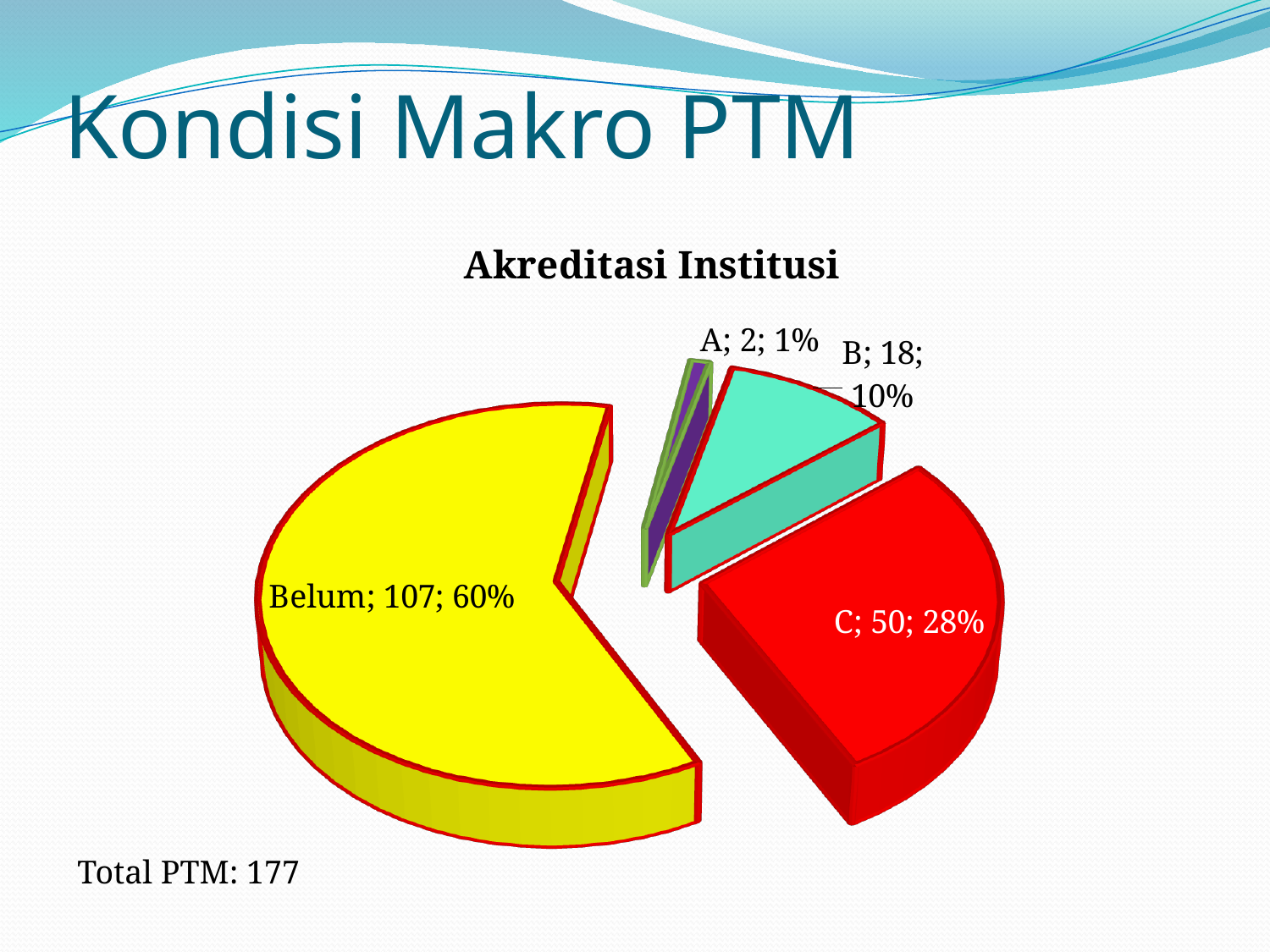
What kind of chart is shown on the slide? pie chart What share of the pie does the Belum slice represent? 60% What is the value for the B slice? 18 Which slice is the smallest? A What is the difference between the values for Belum and C? 57 What is the value for the A slice? 2 How many slices does the pie chart have? 4 What is the title of the chart? Akreditasi Institusi What share of the pie does the C slice represent? 28% Which slice is the largest? Belum What is the value for the C slice? 50 What is the value for the Belum slice? 107